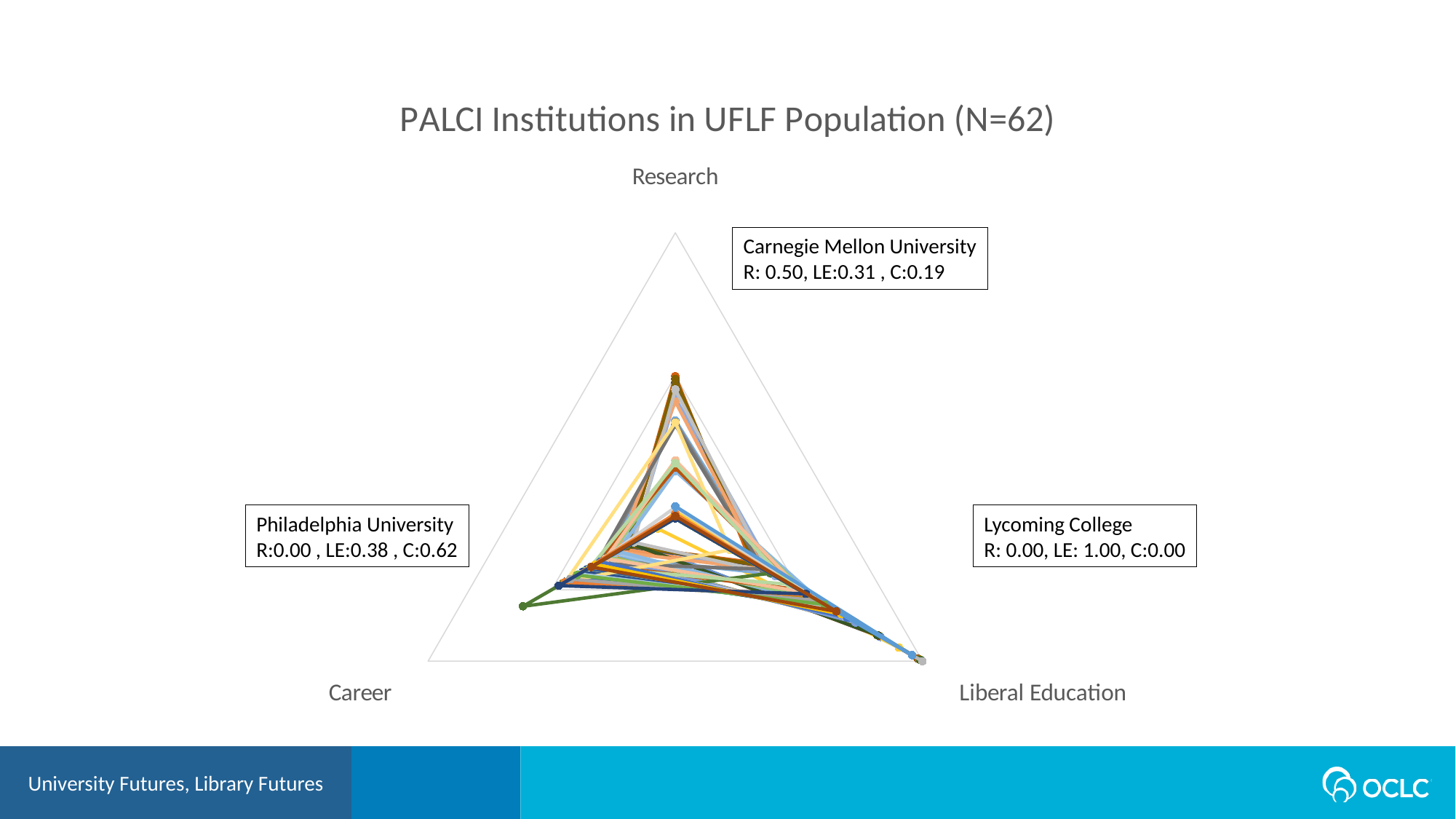
What is the Research (R) value for Carnegie Mellon University? 0.50 What is the difference between the Career (C) values of Philadelphia University and Carnegie Mellon University? 0.43 How many axes (dimensions) does the radar chart have? 3 What is the Liberal Education (LE) value for Philadelphia University? 0.38 What is the Career (C) value for Carnegie Mellon University? 0.19 What is the title of the chart? PALCI Institutions in UFLF Population (N=62) What are the three axis labels on the radar chart? Research, Liberal Education, Career Which has a larger Career (C) value, Philadelphia University or Carnegie Mellon University? Philadelphia University Which of the three annotated institutions has the highest Liberal Education (LE) value? Lycoming College What type of chart is shown on the slide? Radar chart What is the Liberal Education (LE) value for Lycoming College? 1.00 What is the Career (C) value for Philadelphia University? 0.62